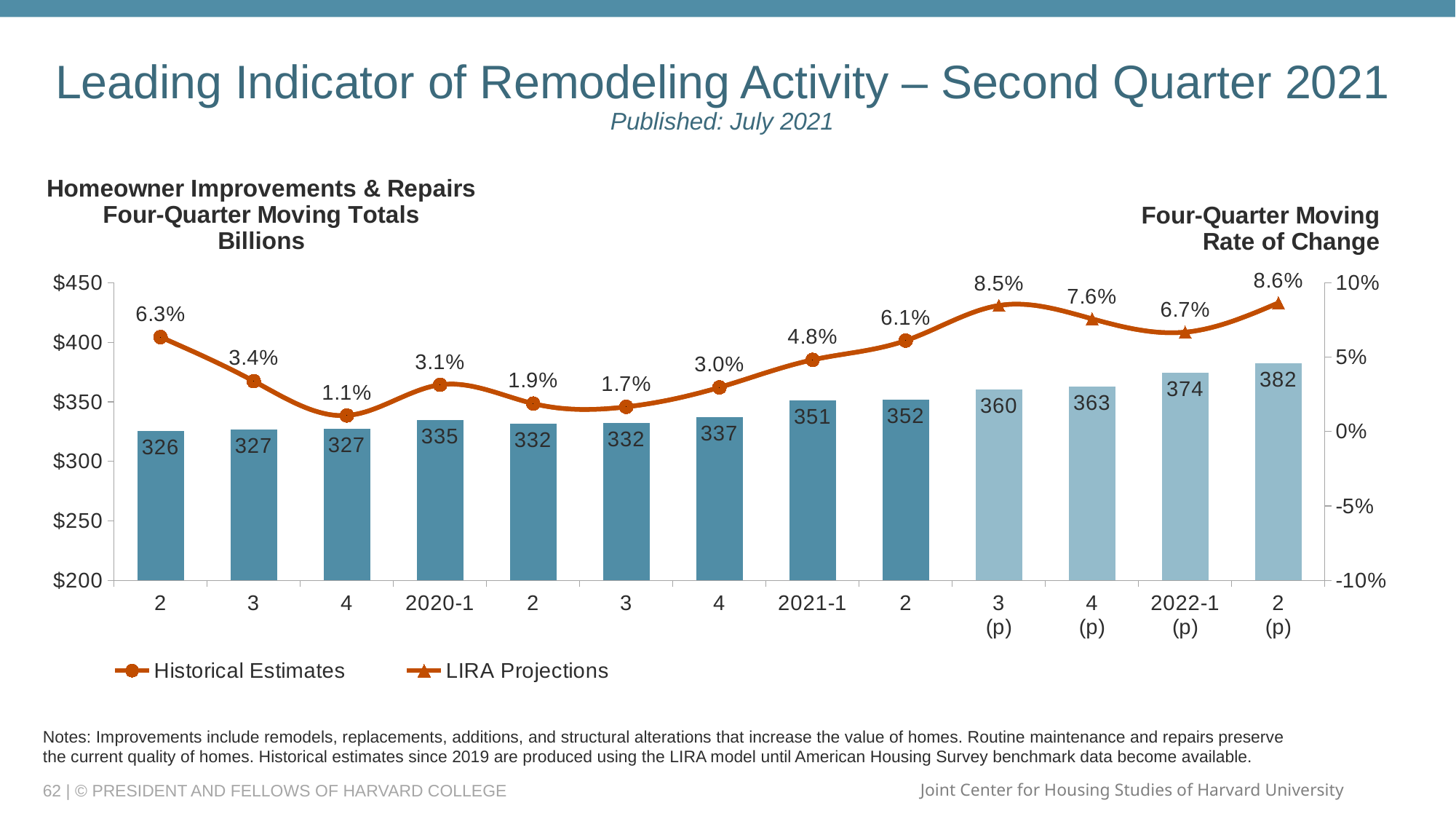
How many series does the legend list? 2 Which quarter has the highest four-quarter moving total bar? 2 (p) (2022) Do the four-quarter moving totals rise or fall from 2021-1 to 2 (p) of 2022? Rise What is the projected four-quarter moving total for 2022-1 (p)? 374 Which quarter has the lowest four-quarter moving rate of change on the line? 4 (2019), at 1.1% How many bars are plotted in the chart? 13 What are the two series named in the legend? Historical Estimates and LIRA Projections What is the four-quarter moving rate of change for 2020-1? 3.1% What is the difference between the four-quarter moving totals for 2 (p) of 2022 and 2021-1? 31 Which is larger, the rate of change for 3 (p) of 2021 or for 2 (p) of 2022? 2 (p) of 2022 (8.6%) What kind of chart is shown on the slide? Combined bar and line chart What is the four-quarter moving total (in billions) for 2021-1? 351